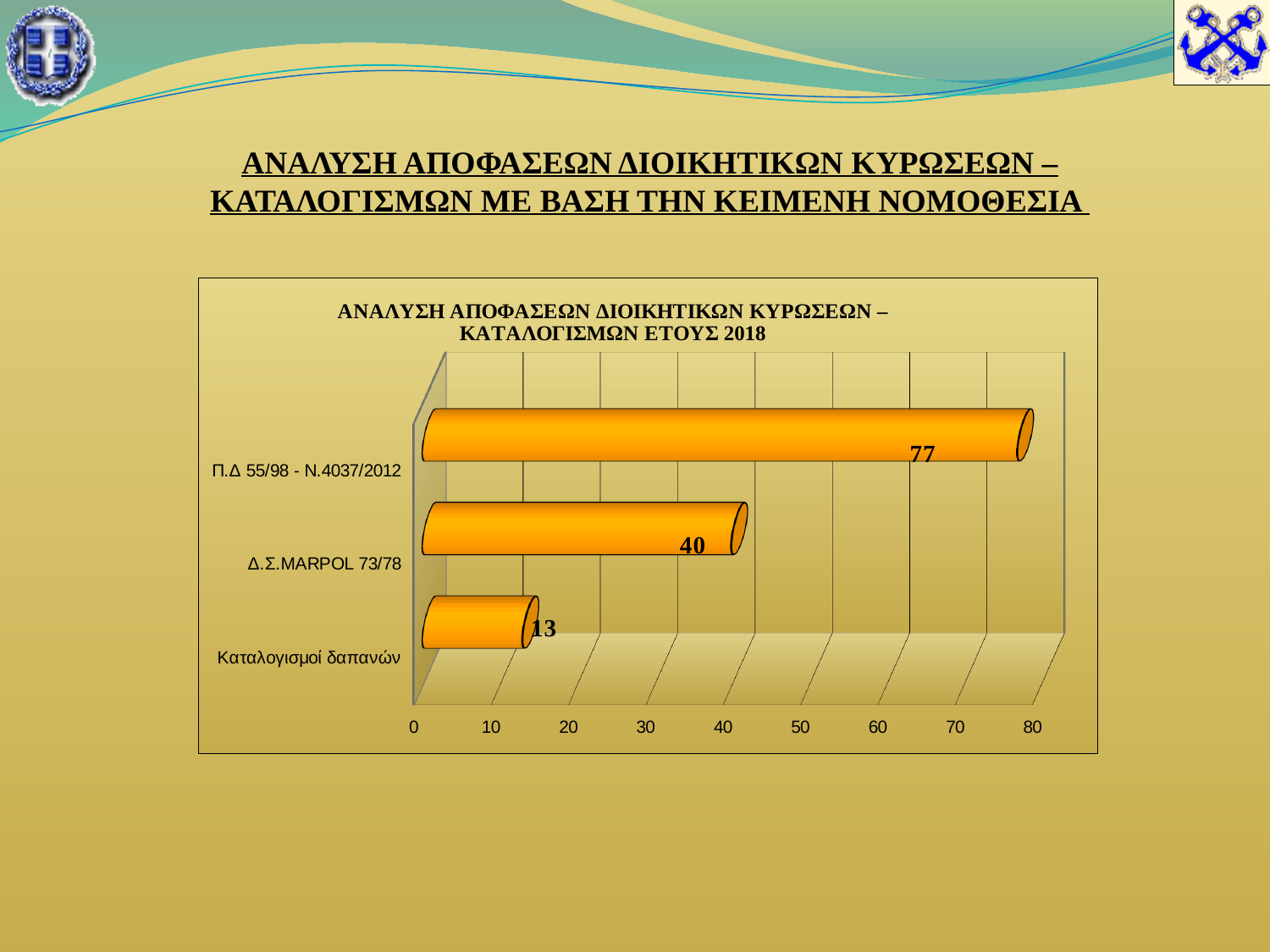
What is the difference between the values for Δ.Σ.MARPOL 73/78 and Καταλογισμοί δαπανών? 27 What is the difference between the values for Π.Δ 55/98 - Ν.4037/2012 and Δ.Σ.MARPOL 73/78? 37 Which is larger, the value for Δ.Σ.MARPOL 73/78 or the value for Καταλογισμοί δαπανών? Δ.Σ.MARPOL 73/78 Is the value for Π.Δ 55/98 - Ν.4037/2012 greater or less than 70? greater Which category has the lowest value? Καταλογισμοί δαπανών What is the value for Δ.Σ.MARPOL 73/78? 40 Which category has the highest value? Π.Δ 55/98 - Ν.4037/2012 What is the title of the chart? ΑΝΑΛΥΣΗ ΑΠΟΦΑΣΕΩΝ ΔΙΟΙΚΗΤΙΚΩΝ ΚΥΡΩΣΕΩΝ – ΚΑΤΑΛΟΓΙΣΜΩΝ ΕΤΟΥΣ 2018 What kind of chart is shown on the slide? bar chart What is the value for Καταλογισμοί δαπανών? 13 How many categories are shown in the chart? 3 What is the value for Π.Δ 55/98 - Ν.4037/2012? 77